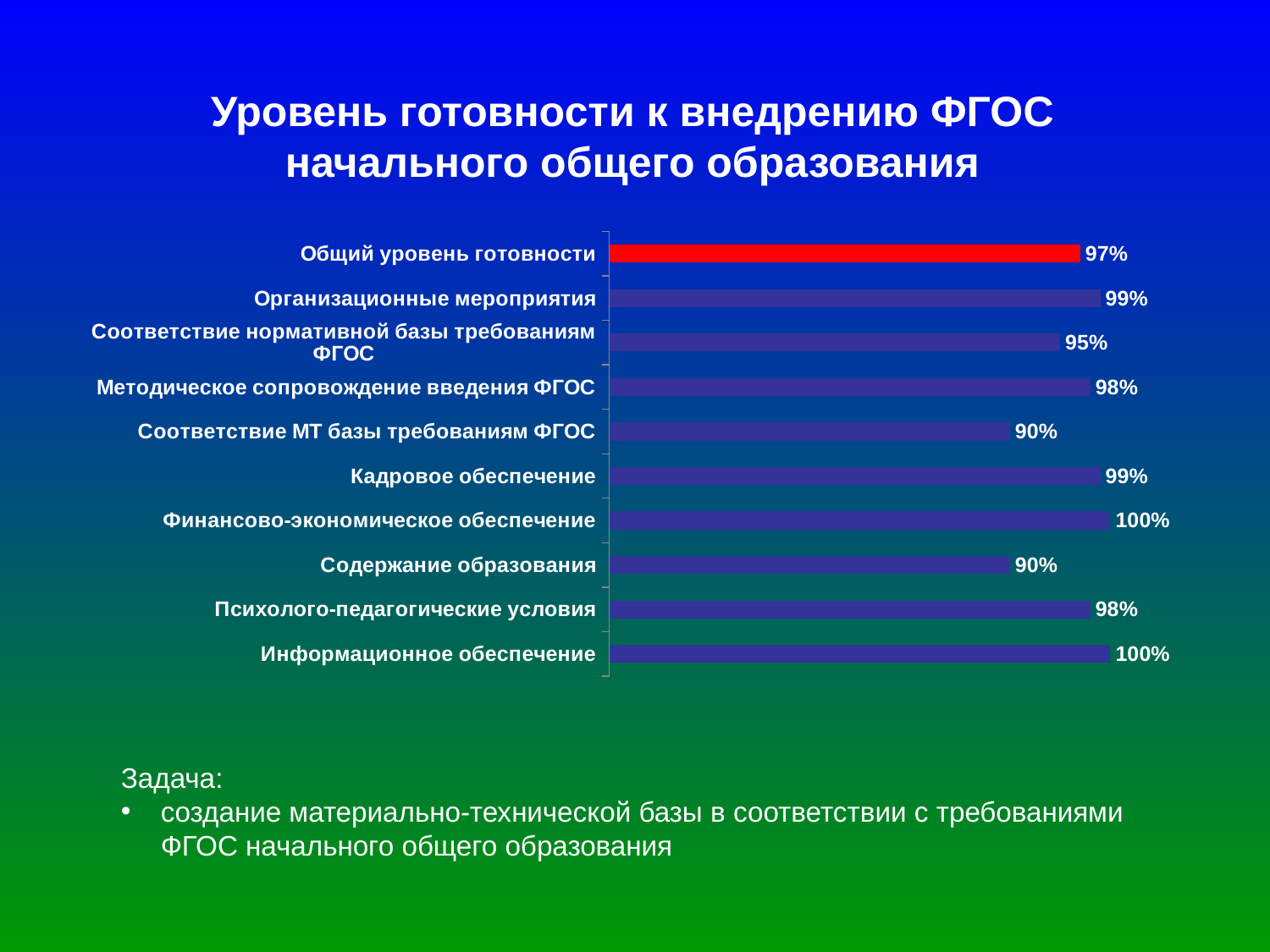
Which is larger, the value for Кадровое обеспечение or the value for Соответствие нормативной базы требованиям ФГОС? Кадровое обеспечение What is the highest value shown in the chart? 100% What is the value for Психолого-педагогические условия? 98% What is the value for Соответствие МТ базы требованиям ФГОС? 90% How many categories are shown in the chart? 10 What is the value for Финансово-экономическое обеспечение? 100% Which bar in the chart is coloured red rather than blue? Общий уровень готовности What type of chart is shown on the slide? Bar chart What is the value for Общий уровень готовности? 97% What is the value for Соответствие нормативной базы требованиям ФГОС? 95% Which two categories have the lowest value in the chart? Соответствие МТ базы требованиям ФГОС and Содержание образования What is the difference between the values for Организационные мероприятия and Содержание образования? 9%